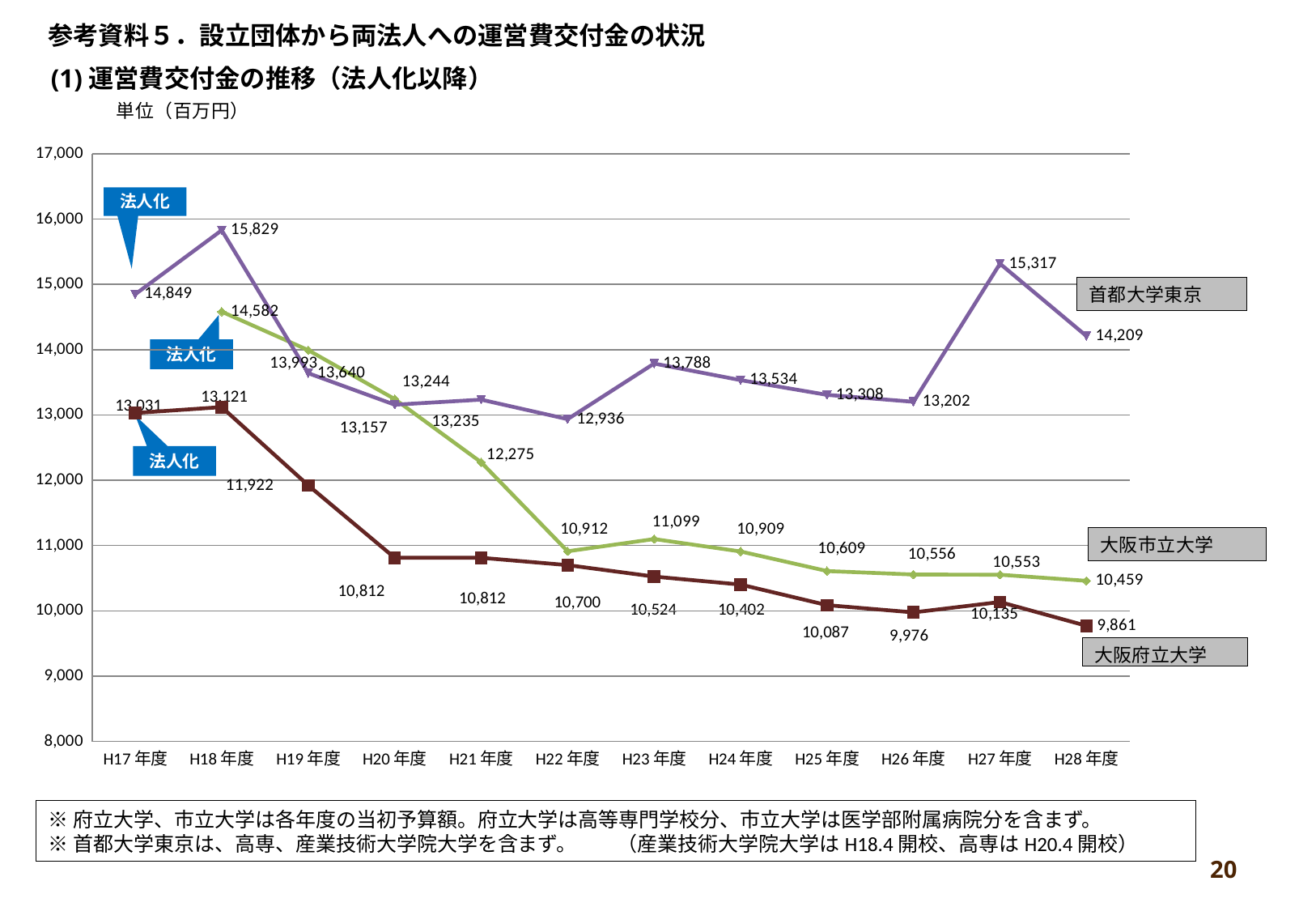
How many fiscal years are shown on the x axis? 12 What is the value for 大阪市立大学 in H18年度? 14,582 In H28年度, which is larger: 大阪市立大学 or 大阪府立大学? 大阪市立大学 What is the value for 大阪府立大学 in H17年度? 13,031 In which year is the value for 大阪府立大学 lowest? H28年度 How many data series (lines) are plotted on the chart? 3 What kind of chart is shown on the slide? Line chart What is the difference between the 首都大学東京 values for H18年度 and H17年度? 980 What is the difference between 大阪市立大学 and 大阪府立大学 in H28年度? 598 What is the value for 首都大学東京 in H27年度? 15,317 In which year is the value for 首都大学東京 highest? H18年度 What is the value for 首都大学東京 in H28年度? 14,209